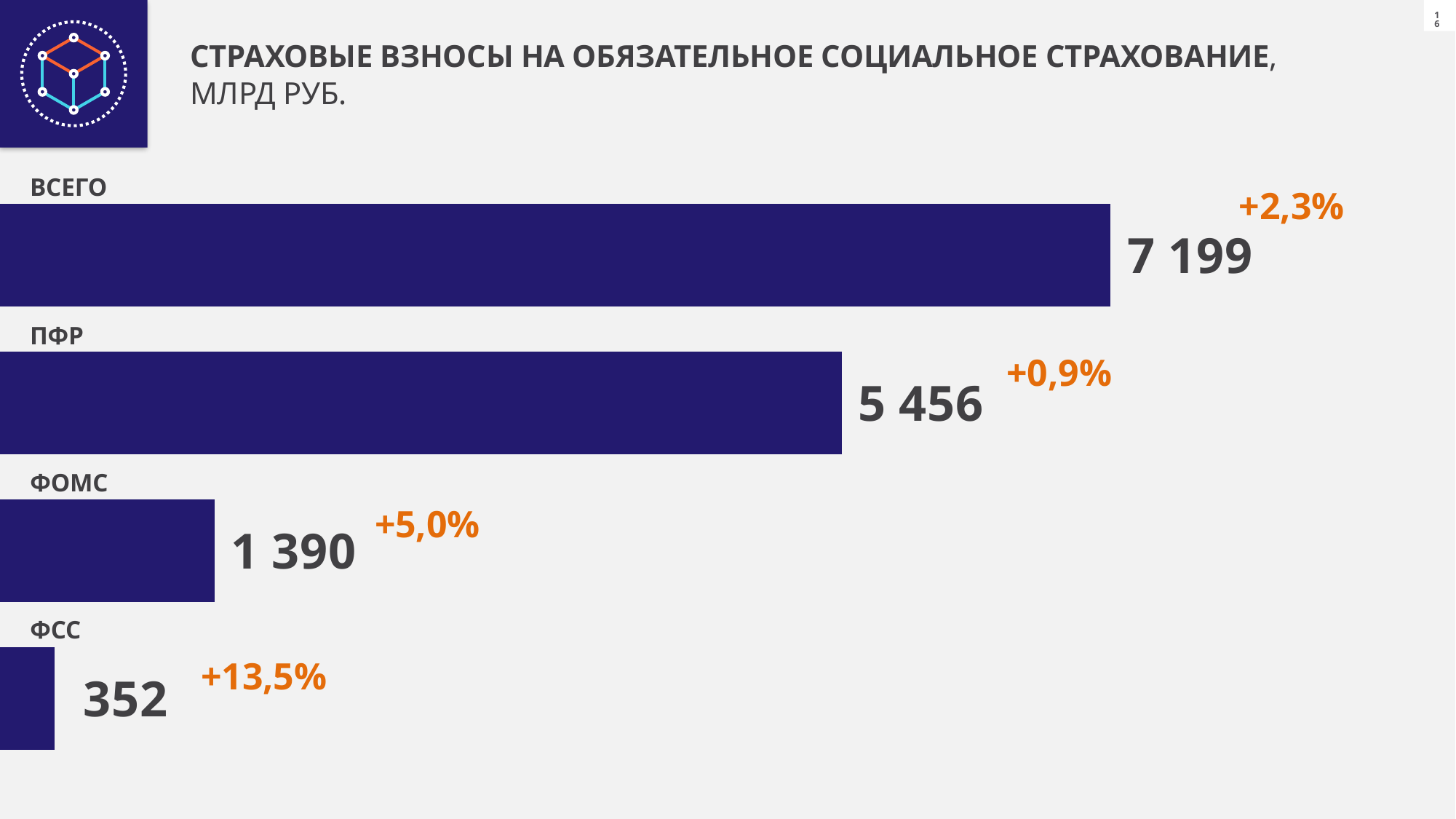
What is the value for ВСЕГО? 7 199 Which category has the lowest value? ФСС Which is larger, the value for ФОМС or the value for ФСС? ФОМС What is the value for ПФР? 5 456 What kind of chart is shown on the slide? Bar chart Which category has the highest value? ВСЕГО What percentage change is shown next to ПФР? +0,9% What is the value for ФСС? 352 How many bars are shown in the chart? 4 What is the value for ФОМС? 1 390 What is the difference between the values for ПФР and ФОМС? 4 066 What percentage change is shown next to ФСС? +13,5%